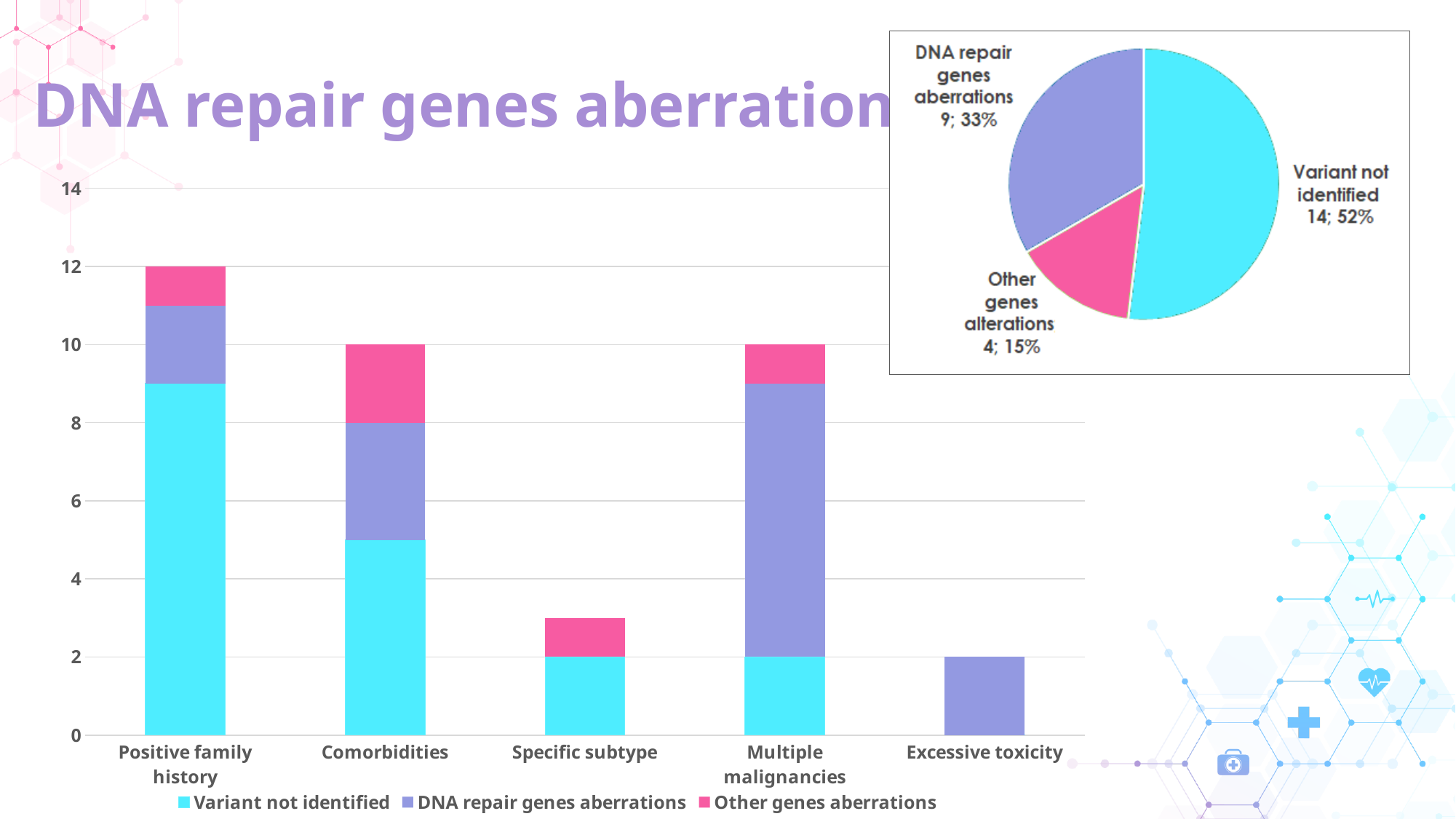
On the stacked bar chart on the left, which series is shown in pink according to the legend? Other genes aberrations On the pie chart in the top right, what share of the pie is 'Variant not identified'? 52% On the stacked bar chart on the left, how many categories are shown on the x axis? 5 On the stacked bar chart on the left, which category has the shortest stacked bar? Excessive toxicity On the pie chart in the top right, what percentage is shown for 'Other genes alterations'? 15% On the pie chart in the top right, how many cases are labelled 'DNA repair genes aberrations'? 9 On the stacked bar chart on the left, how many series does the legend list? 3 On the stacked bar chart on the left, what is the total height of the 'Positive family history' bar? 12 On the stacked bar chart on the left, which category has the tallest stacked bar? Positive family history On the pie chart in the top right, what is the difference between the count for 'Variant not identified' and the count for 'Other genes alterations'? 10 On the pie chart in the top right, which slice is the smallest? Other genes alterations On the stacked bar chart on the left, is the total for 'Specific subtype' greater or less than 4? less